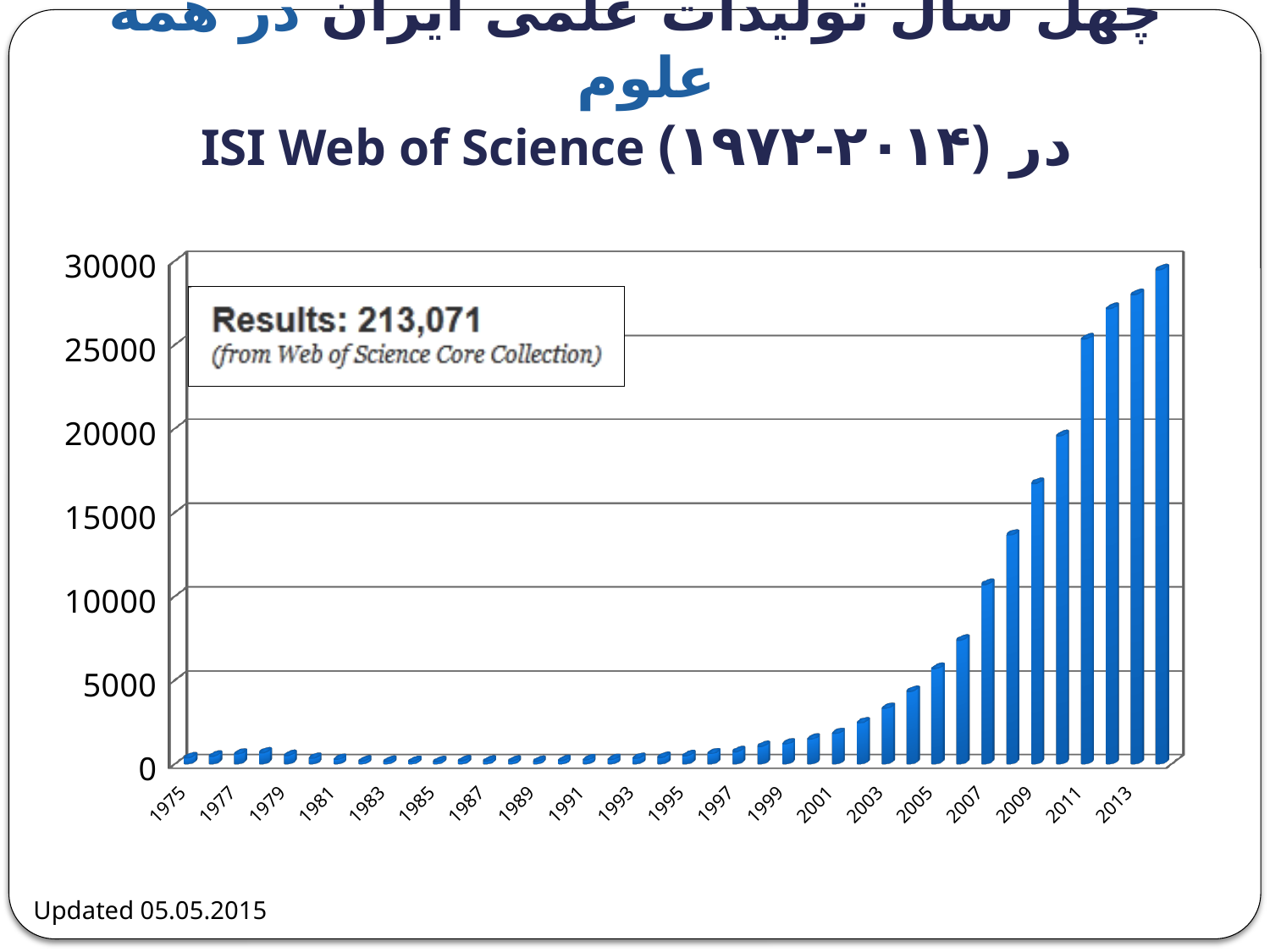
Which year has the larger value, 2003 or 2009? 2009 What is the highest value shown on the y axis? 30000 Is the value for 2009 greater or less than 15000? greater What total number of results is stated in the box inside the chart? 213,071 Is the value for 2013 greater or less than 25000? greater Is the value for 1995 greater or less than 5000? less What kind of chart is shown on the slide? bar chart Which year has the larger value, 2011 or 2013? 2013 Do the values generally rise or fall from 1975 to the right end of the x axis? rise